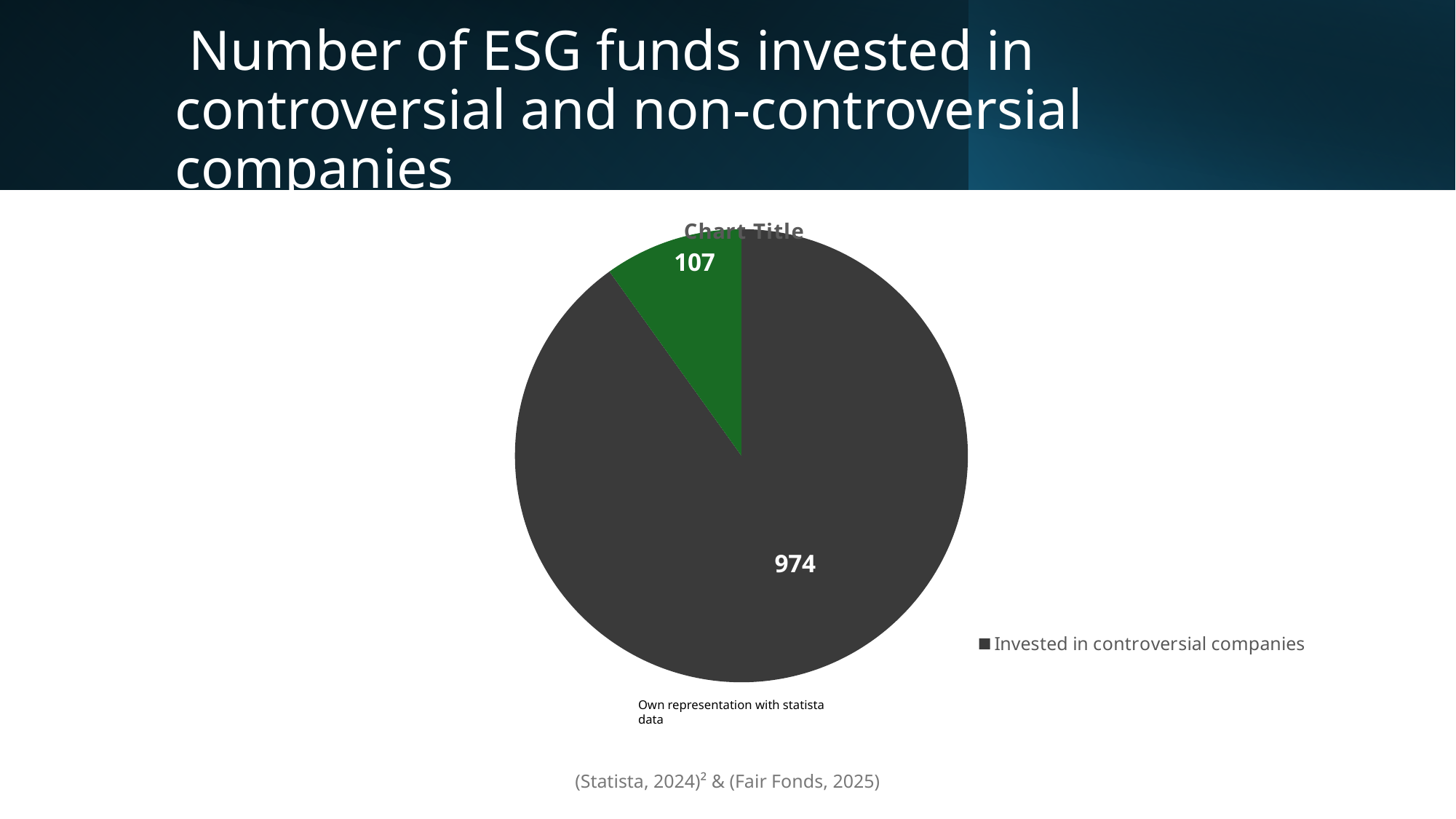
Which is larger in the pie chart: the dark grey slice or the green slice? the dark grey slice What is the total of the two values shown in the pie chart? 1081 What kind of chart is shown on the slide? pie chart Which slice of the pie chart is the largest? Invested in controversial companies What is the value for 'Invested in controversial companies' in the pie chart? 974 What share of the pie does the 'Invested in controversial companies' slice (974 out of 1081) represent? 90.1% What value is printed on the green slice of the pie chart? 107 What is the difference between the two values shown in the pie chart, 974 and 107? 867 What is the value of the smallest slice in the pie chart? 107 What placeholder title text appears above the pie chart? Chart Title How many slices does the pie chart have? 2 What legend entry is shown next to the pie chart? Invested in controversial companies